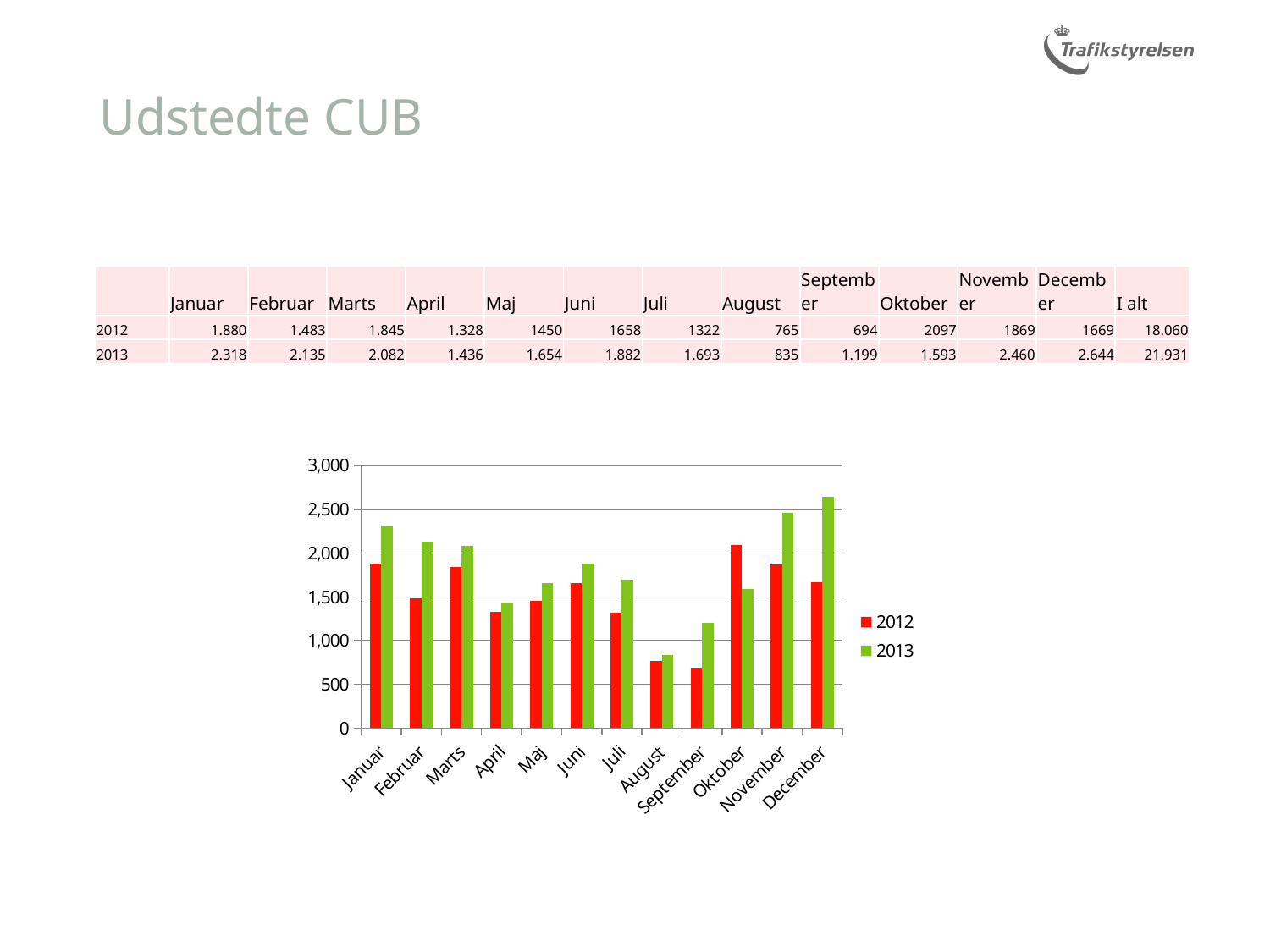
Which colour represents the 2013 series in the chart? green Is the value for 2013 in November greater or less than 2,000? greater How many months are shown on the x axis of the chart? 12 In Oktober, which series has the larger value, 2012 or 2013? 2012 What type of chart is shown on the slide? bar chart Which month has the lowest value for 2013? August Which month has the highest value for 2013? December What is the difference between the 2013 and 2012 values in August? 70 What is the value for 2013 in Januar? 2.318 How many series does the chart legend list? 2 What is the value for 2012 in Oktober? 2097 Which month has the lowest value for 2012? September